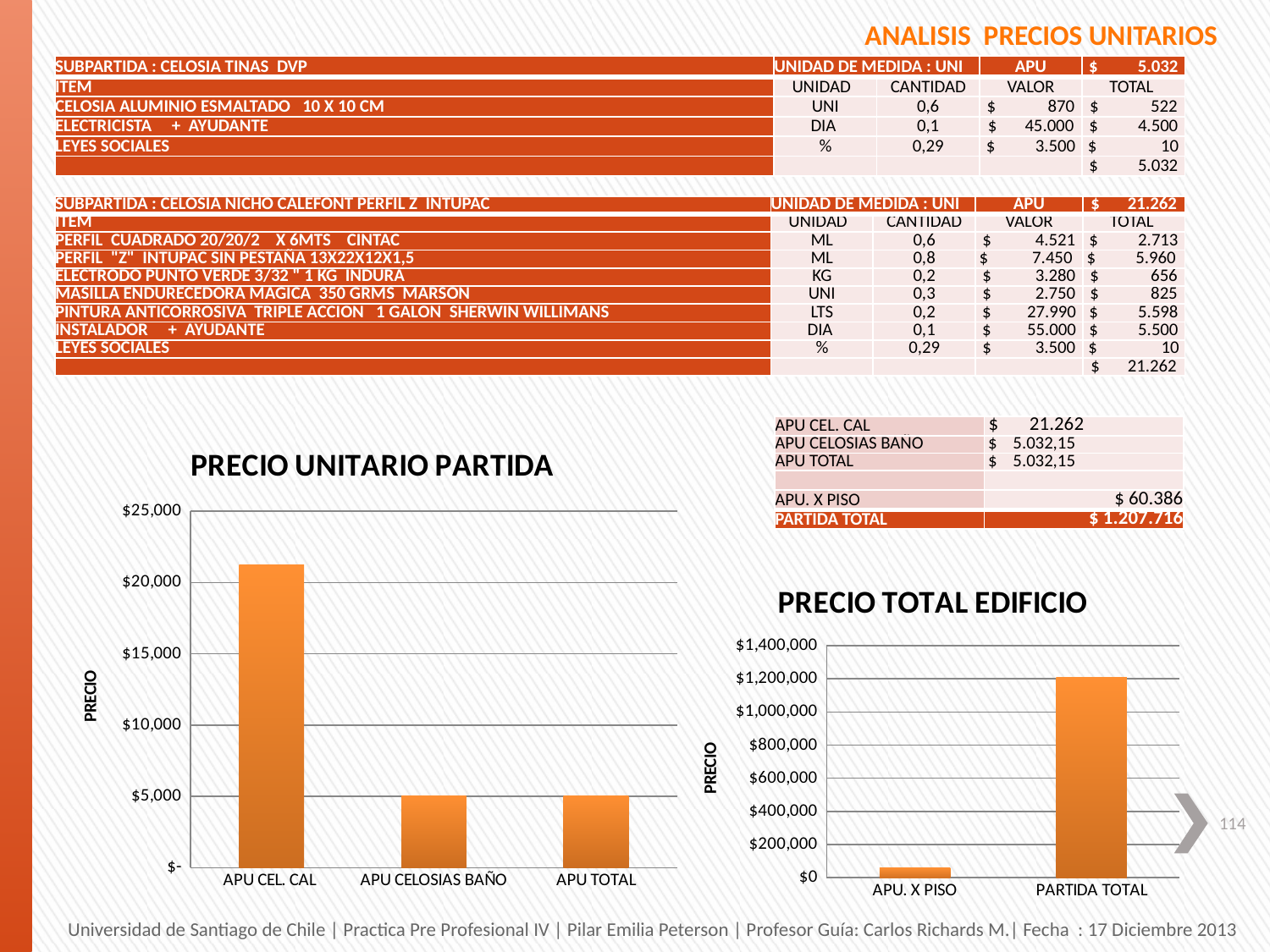
How many categories are shown in the "PRECIO TOTAL EDIFICIO" chart? 2 In the "PRECIO UNITARIO PARTIDA" chart, which is larger: APU CEL. CAL or APU TOTAL? APU CEL. CAL In the "PRECIO UNITARIO PARTIDA" chart, is the value for APU CEL. CAL greater or less than $20,000? greater In the "PRECIO TOTAL EDIFICIO" chart, is the value for APU. X PISO greater or less than $200,000? less In the "PRECIO TOTAL EDIFICIO" chart, which category has the lowest value? APU. X PISO What kind of chart is the "PRECIO TOTAL EDIFICIO" chart? bar chart How many categories are shown in the "PRECIO UNITARIO PARTIDA" chart? 3 In the "PRECIO UNITARIO PARTIDA" chart, which category has the highest value? APU CEL. CAL What kind of chart is the "PRECIO UNITARIO PARTIDA" chart? bar chart In the "PRECIO UNITARIO PARTIDA" chart, is the value for APU CELOSIAS BAÑO greater or less than $10,000? less What is the y-axis label of the "PRECIO UNITARIO PARTIDA" chart? PRECIO